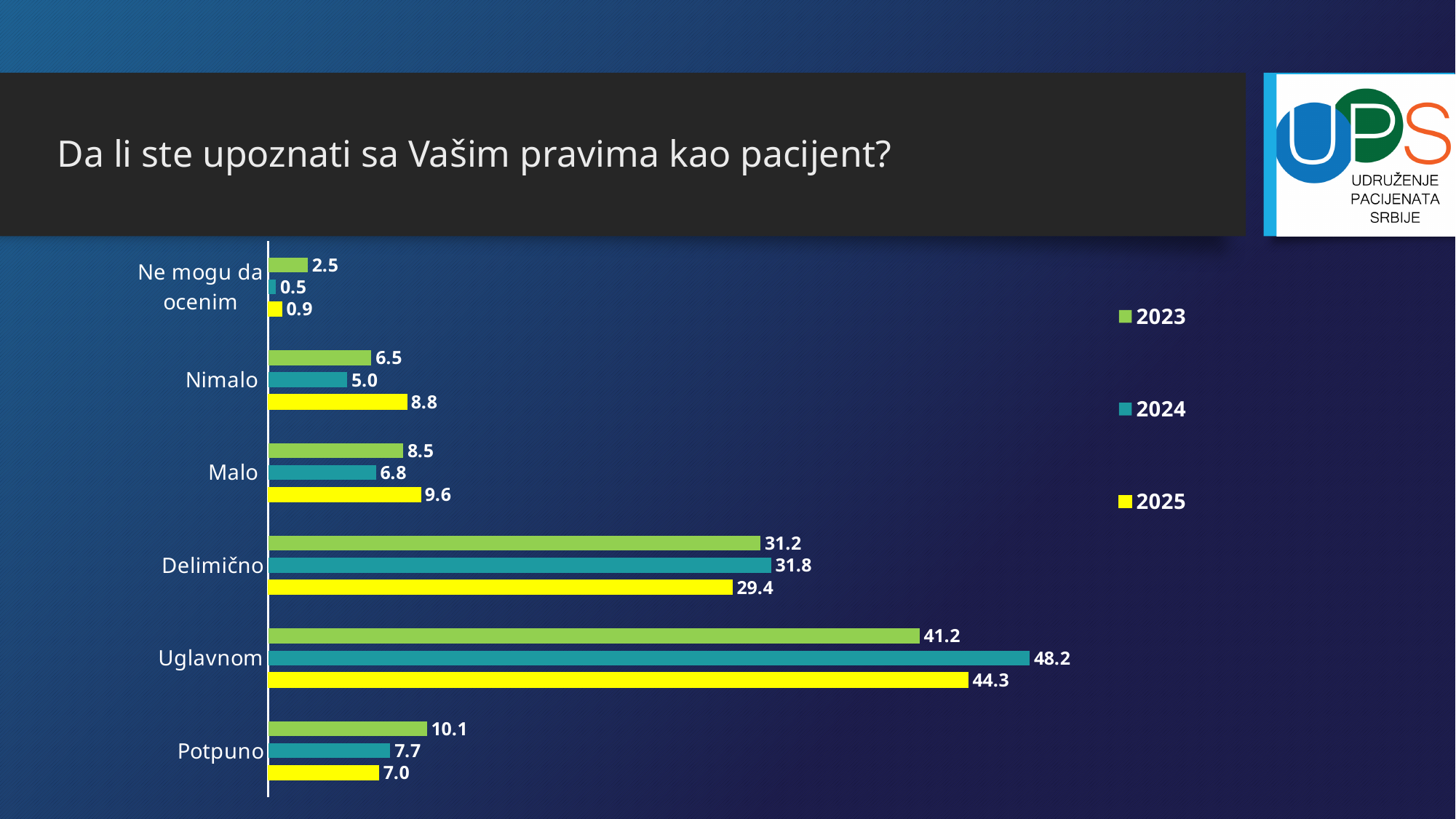
What is the value for Uglavnom in the 2024 series? 48.2 What is the value for Ne mogu da ocenim in the 2023 series? 2.5 Which category has the highest value in the 2025 series? Uglavnom What is the difference between the 2024 and 2023 values for Uglavnom? 7.0 Which category has the lowest value in the 2024 series? Ne mogu da ocenim Which is larger for Potpuno: the 2023 value or the 2025 value? 2023 What is the difference between the 2025 and 2024 values for Nimalo? 3.8 What kind of chart is shown on the slide? bar chart What is the value for Delimično in the 2025 series? 29.4 How many categories are shown on the chart? 6 What is the title of the slide containing the chart? Da li ste upoznati sa Vašim pravima kao pacijent? How many series does the legend list? 3